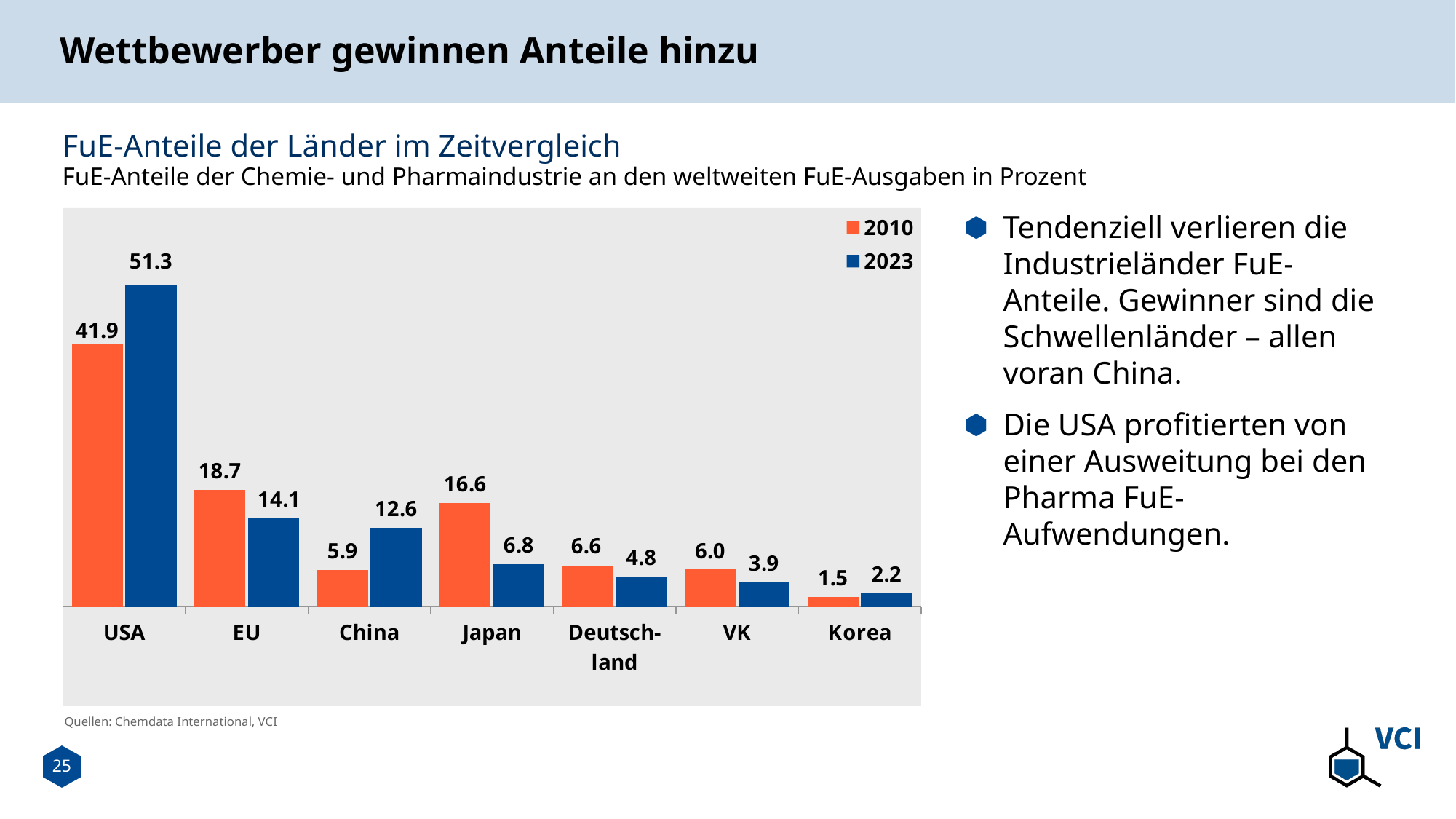
Which country has the lowest value in 2023? Korea What kind of chart is shown on the slide? Bar chart What is the value for China in 2010? 5.9 What is the difference between the USA's 2023 and 2010 values? 9.4 Which colour represents the year 2023 in the chart? Blue How many countries or regions are shown on the x axis? 7 How many series does the legend list? 2 Which is larger: China's 2023 value or Japan's 2023 value? China's 2023 value What is the difference between the EU's 2010 and 2023 values? 4.6 What is the value for the USA in 2023? 51.3 What is the value for Deutschland in 2023? 4.8 Which country has the highest value in 2010? USA